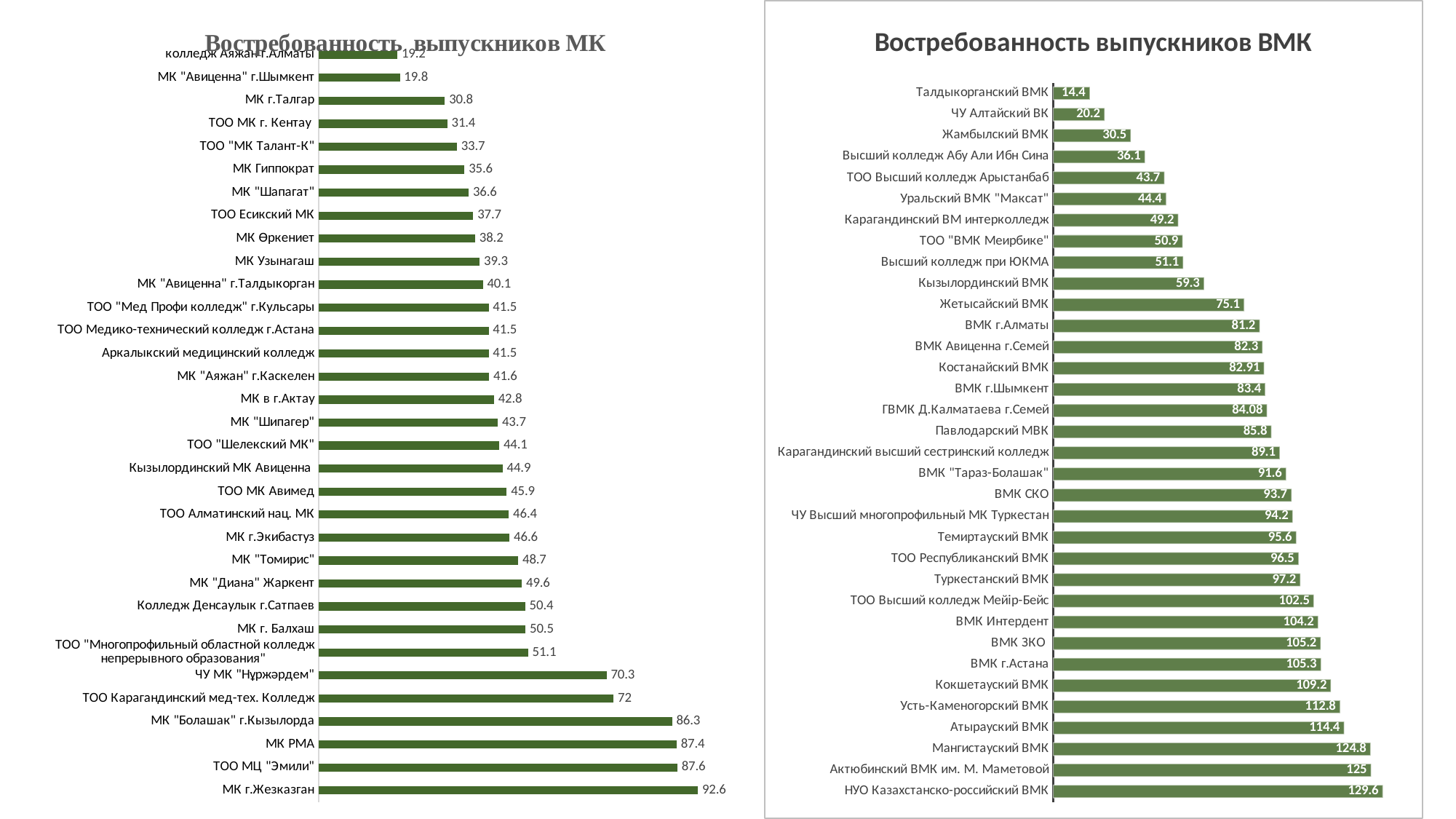
In the chart 'Востребованность выпускников МК', which is larger: МК "Томирис" or МК г.Экибастуз? МК "Томирис" In the chart 'Востребованность выпускников МК', which category has the lowest value? колледж Аяжан г.Алматы In the chart 'Востребованность выпускников МК', what is the difference between МК г.Жезказган and ТОО МЦ "Эмили"? 5 In the chart 'Востребованность выпускников МК', what is the value for ЧУ МК "Нұржәрдем"? 70.3 In the chart 'Востребованность выпускников ВМК', which category has the highest value? НУО Казахстанско-российский ВМК In the chart 'Востребованность выпускников ВМК', how many categories are plotted? 34 In the chart 'Востребованность выпускников ВМК', what is the difference between Актюбинский ВМК им. М. Маметовой and Мангистауский ВМК? 0.2 In the chart 'Востребованность выпускников ВМК', which category has the lowest value? Талдыкорганский ВМК In the chart 'Востребованность выпускников ВМК', what is the value for Костанайский ВМК? 82.91 In the chart 'Востребованность выпускников МК', what is the value for МК г.Жезказган? 92.6 In the chart 'Востребованность выпускников ВМК', what is the value for НУО Казахстанско-российский ВМК? 129.6 What type of chart is 'Востребованность выпускников ВМК'? Bar chart